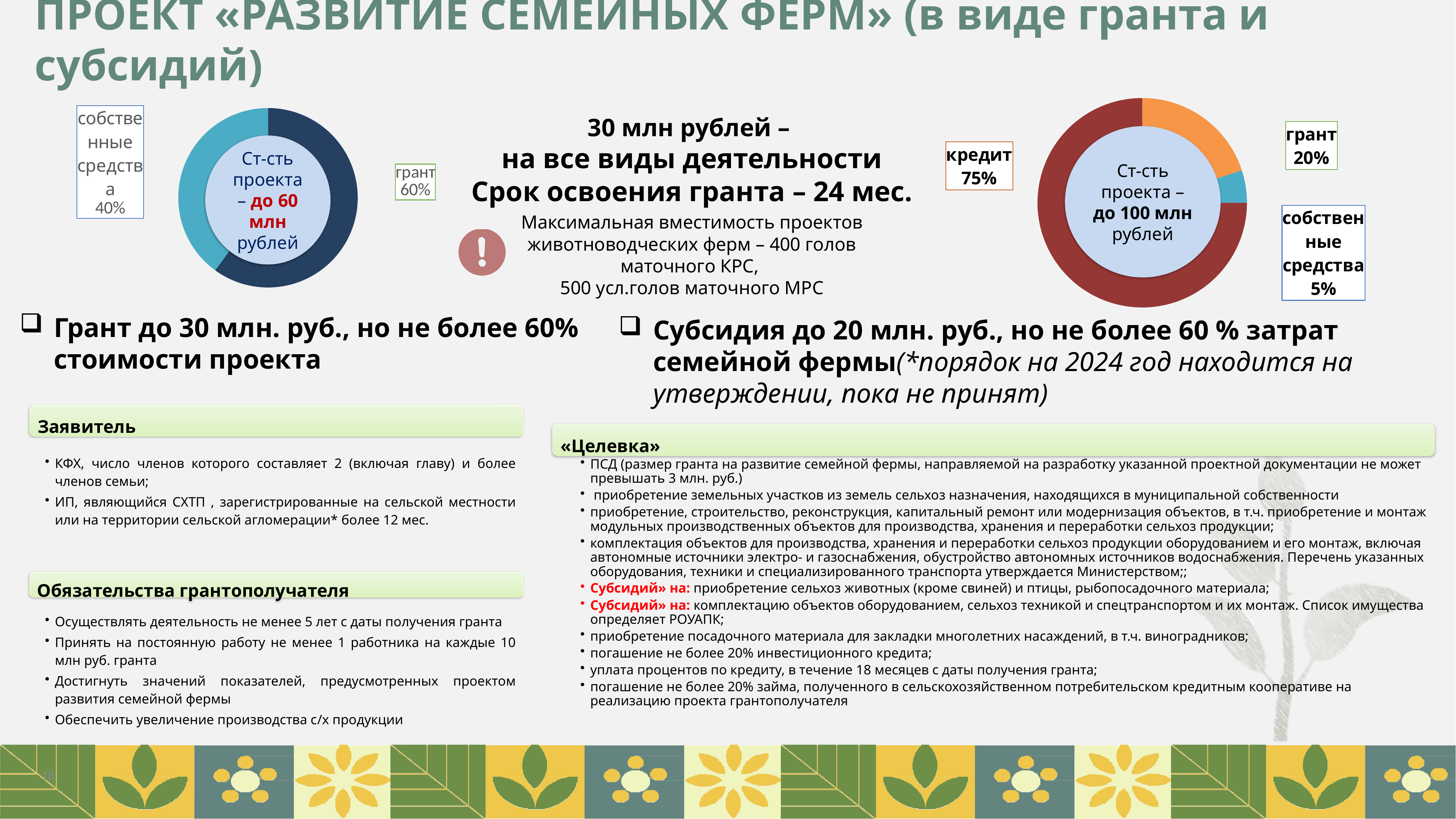
На левой диаграмме (стоимость проекта до 60 млн рублей) какая доля приходится на собственные средства? 40% На правой диаграмме (стоимость проекта до 100 млн рублей) на сколько процентных пунктов доля кредита больше доли гранта? 55% На правой диаграмме (стоимость проекта до 100 млн рублей) какой источник имеет наибольшую долю? кредит Сколько сегментов на правой диаграмме (стоимость проекта до 100 млн рублей)? 3 Какого типа диаграммы показаны на слайде? кольцевые (круговые) диаграммы На правой диаграмме (стоимость проекта до 100 млн рублей) какой источник имеет наименьшую долю? собственные средства На правой диаграмме (стоимость проекта до 100 млн рублей) какая доля приходится на собственные средства? 5% На правой диаграмме (стоимость проекта до 100 млн рублей) какая доля приходится на грант? 20% На правой диаграмме (стоимость проекта до 100 млн рублей) какая доля приходится на кредит? 75% На левой диаграмме (стоимость проекта до 60 млн рублей) что больше: доля гранта или доля собственных средств? грант На левой диаграмме (стоимость проекта до 60 млн рублей) на сколько процентных пунктов доля гранта больше доли собственных средств? 20% На левой диаграмме (стоимость проекта до 60 млн рублей) какая доля приходится на грант? 60%